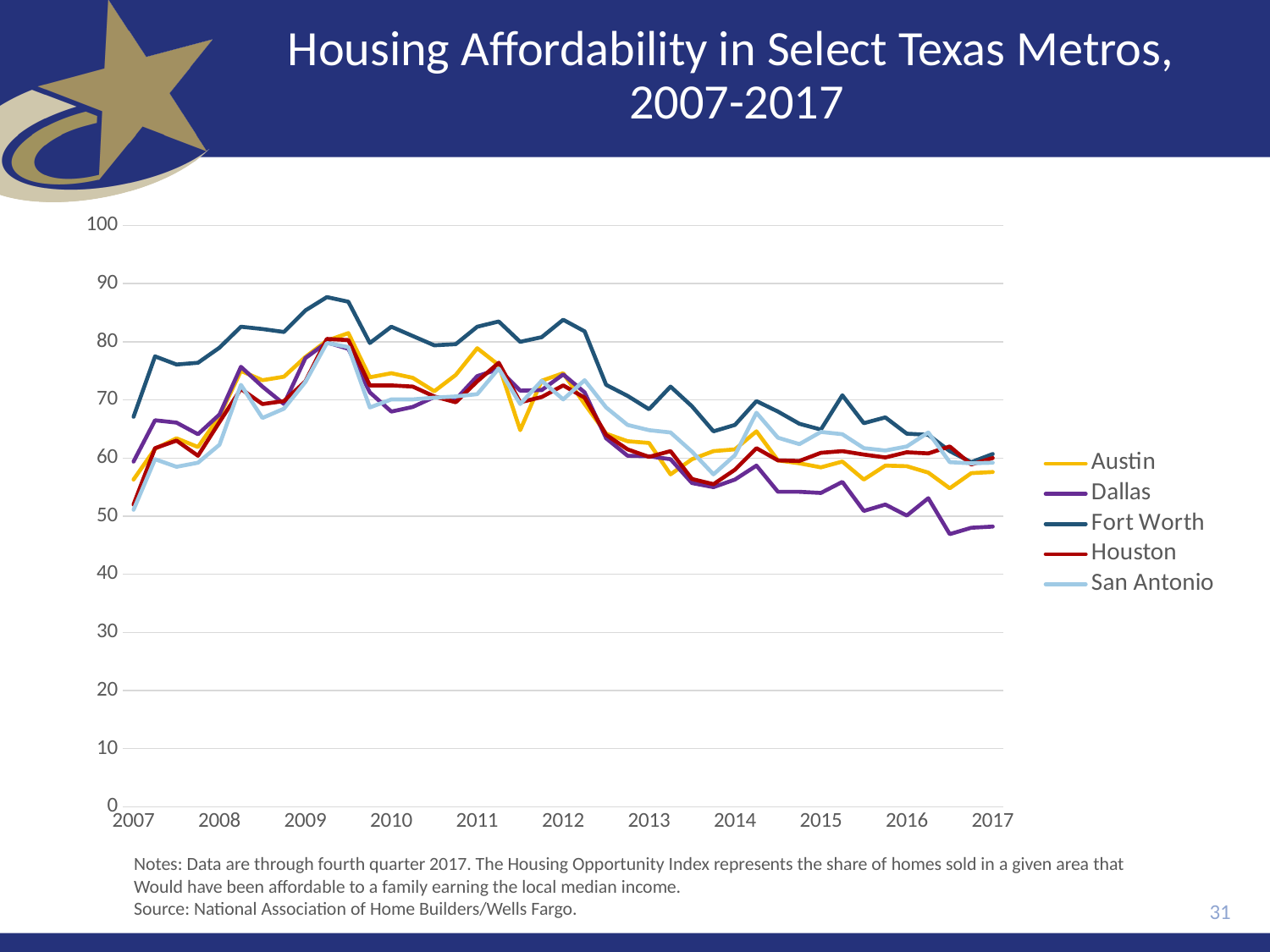
What kind of chart is shown on the slide? line chart Is the value for Fort Worth in 2009 greater or less than 80? greater Which metro has the highest value at the start of 2007? Fort Worth How many series does the legend list? 5 Is the value for Dallas in 2017 greater or less than 50? less Which metro has the lowest value in 2017? Dallas Which is larger in 2015, the value for Fort Worth or the value for Dallas? Fort Worth Does the Dallas line rise or fall from 2012 to 2017? fall What is the title of the chart? Housing Affordability in Select Texas Metros, 2007-2017 Which metro has the highest value in 2009? Fort Worth Which metros are listed in the chart's legend? Austin, Dallas, Fort Worth, Houston, San Antonio Is the value for San Antonio at the start of 2007 greater or less than 60? less